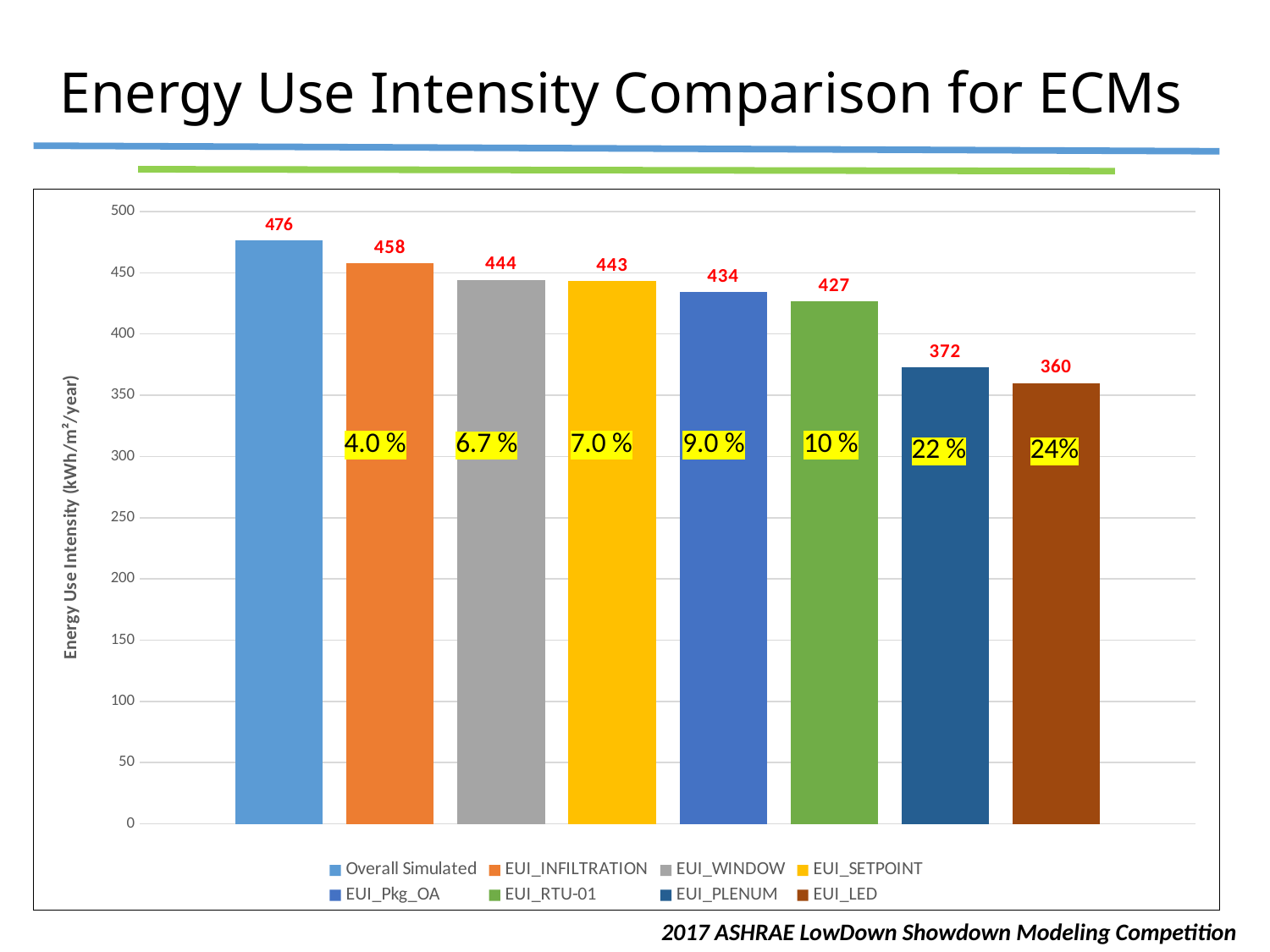
Which series has the lowest Energy Use Intensity? EUI_LED What kind of chart is shown on the slide? Bar chart What is the Energy Use Intensity value for Overall Simulated? 476 Which series has the highest Energy Use Intensity? Overall Simulated How many series does the legend list? 8 What percentage label is shown on the EUI_RTU-01 bar? 10 % What is the Energy Use Intensity value for EUI_LED? 360 What is the difference in Energy Use Intensity between Overall Simulated and EUI_LED? 116 What is the Energy Use Intensity value for EUI_PLENUM? 372 What is the label of the vertical axis? Energy Use Intensity (kWh/m²/year) Is the Energy Use Intensity for EUI_Pkg_OA greater or less than 400? greater Which has a higher Energy Use Intensity, EUI_INFILTRATION or EUI_PLENUM? EUI_INFILTRATION